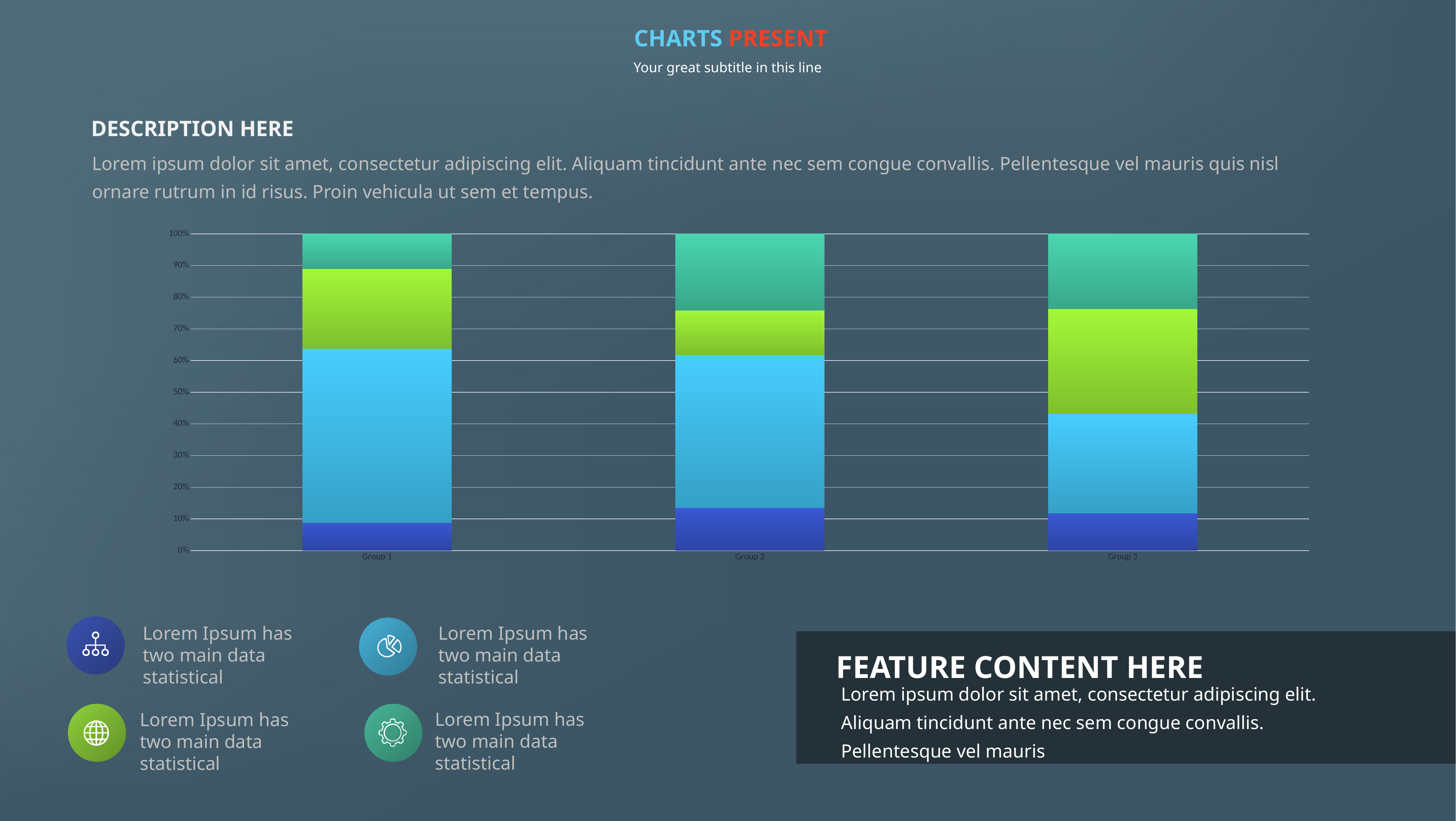
What is the highest value shown on the vertical axis? 100% How many groups are shown on the x axis of the chart? 3 Which group has the largest green segment? Group 3 Is the top of the light blue segment for Group 1 greater or less than 60%? greater What is the total height of the stacked bar for Group 1? 100% What kind of chart is shown on the slide? Stacked bar chart Which group has the smallest green segment? Group 2 Is the light blue segment larger in Group 1 or in Group 3? Group 1 What is the total height of the stacked bar for Group 3? 100% Is the top of the light blue segment for Group 3 greater or less than 50%? less Which group has the smallest teal (top) segment? Group 1 How many coloured segments make up each bar in the chart? 4